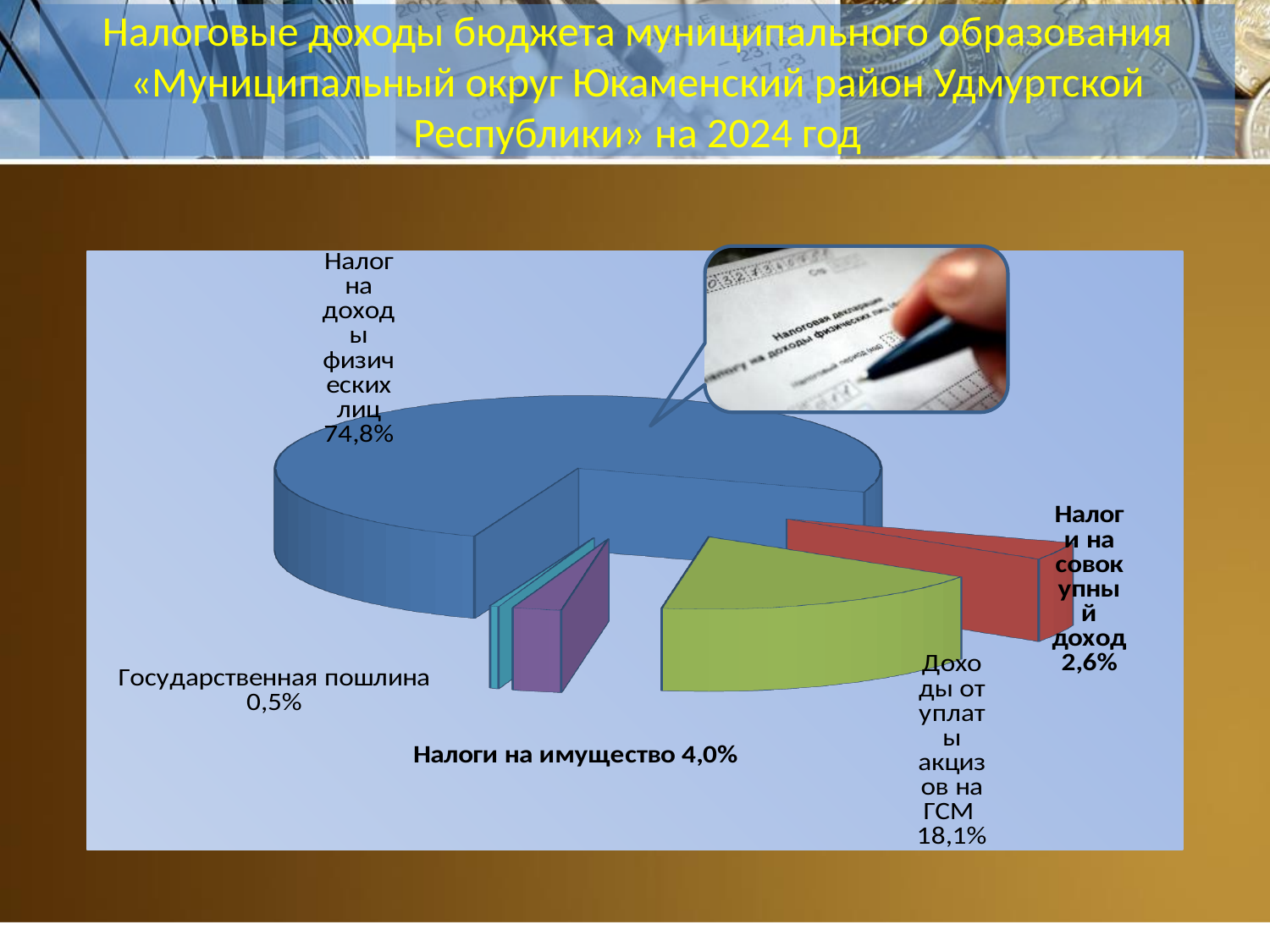
What share is shown for Государственная пошлина? 0,5% What share is shown for Налоги на имущество? 4,0% What share of tax revenues comes from Налог на доходы физических лиц? 74,8% What share is shown for Налоги на совокупный доход? 2,6% What is the difference in percentage points between Налог на доходы физических лиц and Доходы от уплаты акцизов на ГСМ? 56,7 What year does the chart title refer to? 2024 What share is shown for Доходы от уплаты акцизов на ГСМ? 18,1% Which is larger: Налоги на имущество or Налоги на совокупный доход? Налоги на имущество Which category has the largest share of the pie? Налог на доходы физических лиц Which category has the smallest share of the pie? Государственная пошлина How many categories (slices) does the pie chart show? 5 What type of chart is shown on the slide? Pie chart